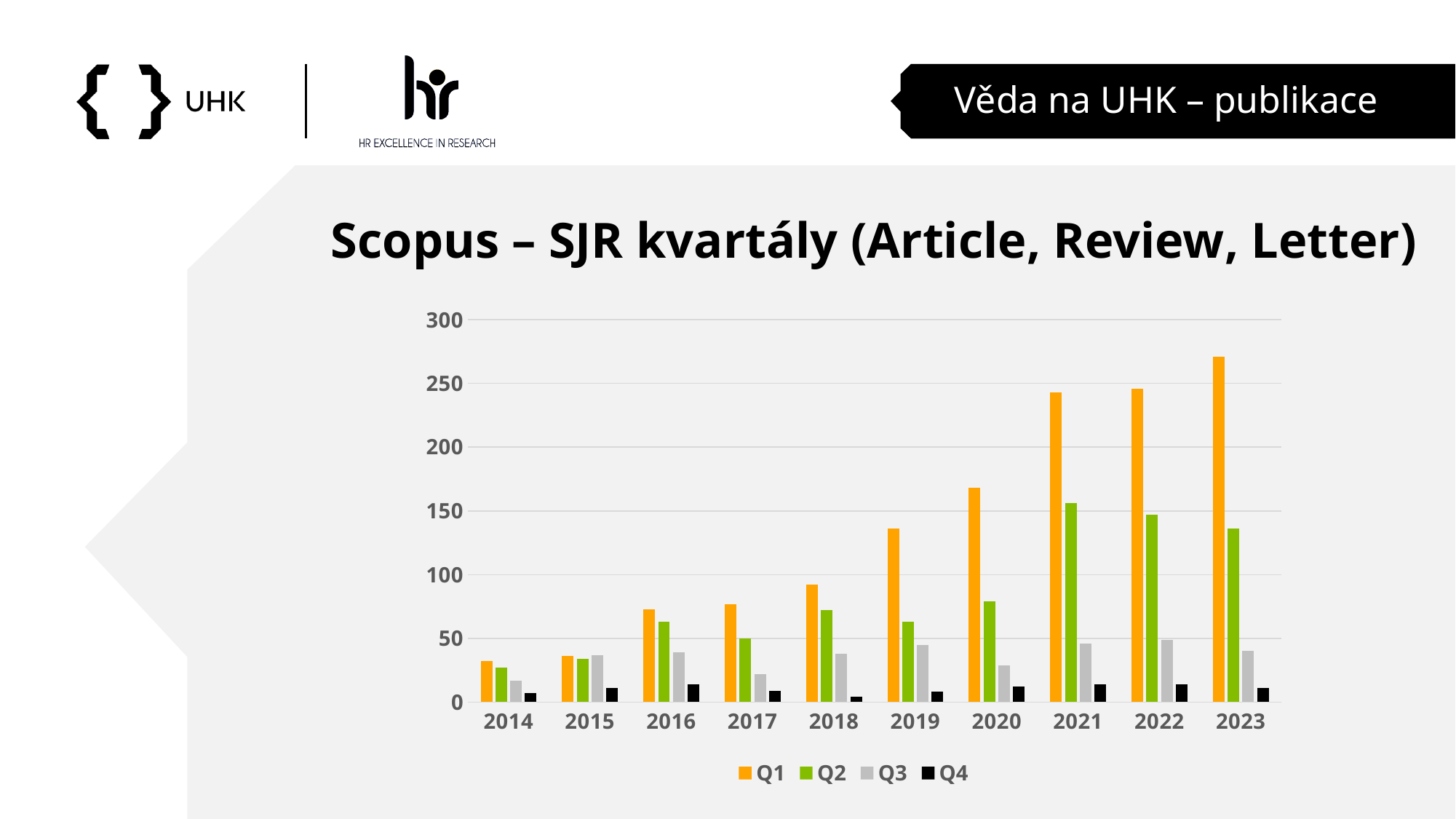
Does the Q1 series generally rise or fall from 2014 to 2023? rise Is the Q2 value for 2021 greater or less than 100? greater Which year has the lowest Q1 value? 2014 Is the Q3 value for 2014 greater or less than 50? less In 2023, which is larger, the Q1 value or the Q2 value? Q1 How many series does the chart's legend list? 4 How many years are shown on the x axis of the chart? 10 Is the Q1 value for 2020 greater or less than 150? greater What kind of chart is shown on the slide? bar chart Which year has the highest Q1 value? 2023 Which year has the larger Q2 value, 2016 or 2017? 2016